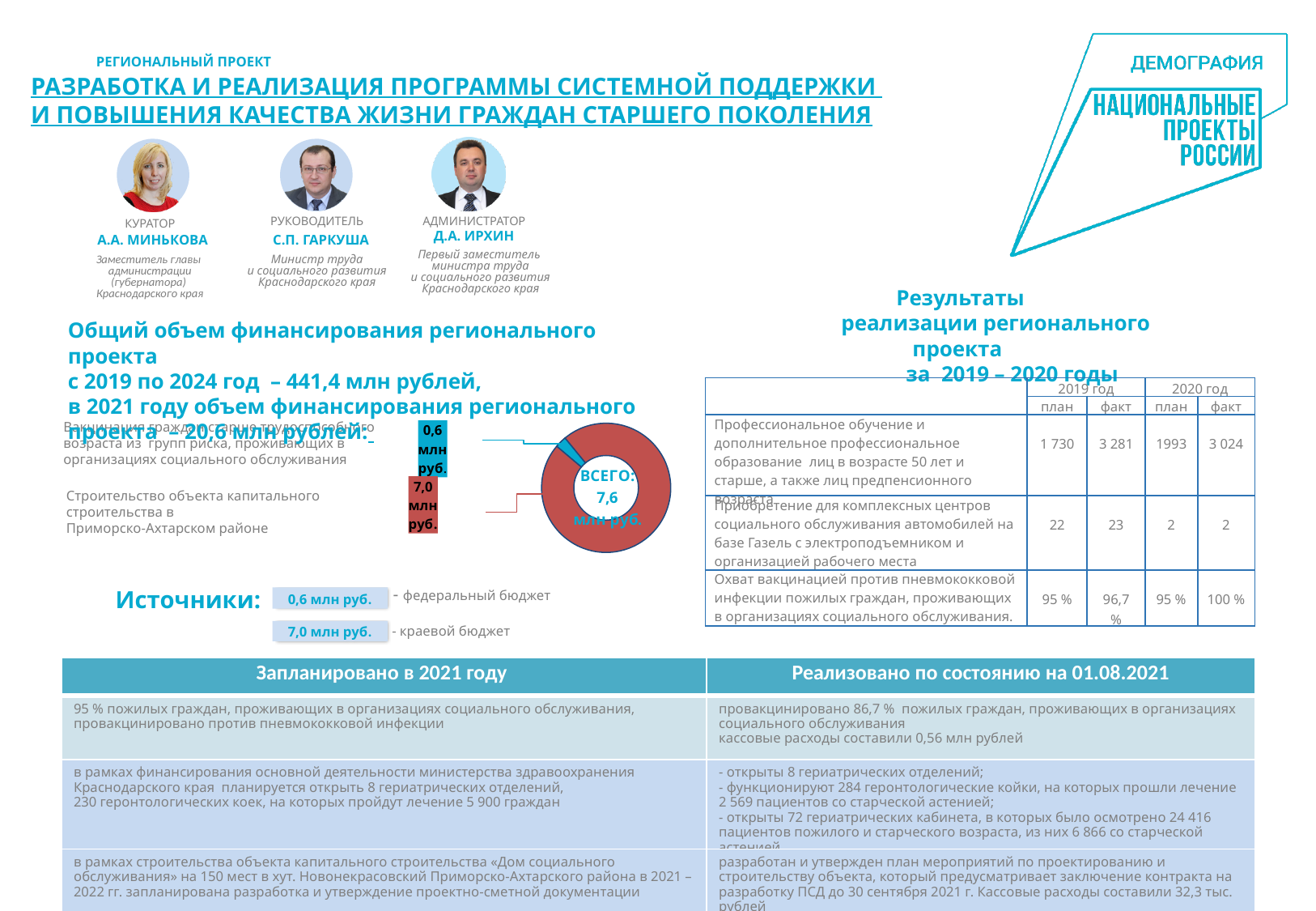
What is the difference between the construction value and the vaccination value in the doughnut chart? 6,4 млн руб. What total is shown in the centre of the doughnut chart? 7,6 млн руб. What is the value for 'Строительство объекта капитального строительства в Приморско-Ахтарском районе' in the doughnut chart? 7,0 млн руб. What is the value for 'Вакцинация граждан старше трудоспособного возраста из групп риска' in the doughnut chart? 0,6 млн руб. How many slices does the doughnut chart have? 2 What colour is the vaccination slice in the doughnut chart? Blue Which category has the smallest slice in the doughnut chart? Вакцинация граждан старше трудоспособного возраста из групп риска What colour is the construction slice in the doughnut chart? Red Which is larger in the doughnut chart: the vaccination value or the construction value? Construction (7,0 млн руб.) What kind of chart is shown on the slide? Pie (doughnut) chart Which category has the largest slice in the doughnut chart? Строительство объекта капитального строительства в Приморско-Ахтарском районе